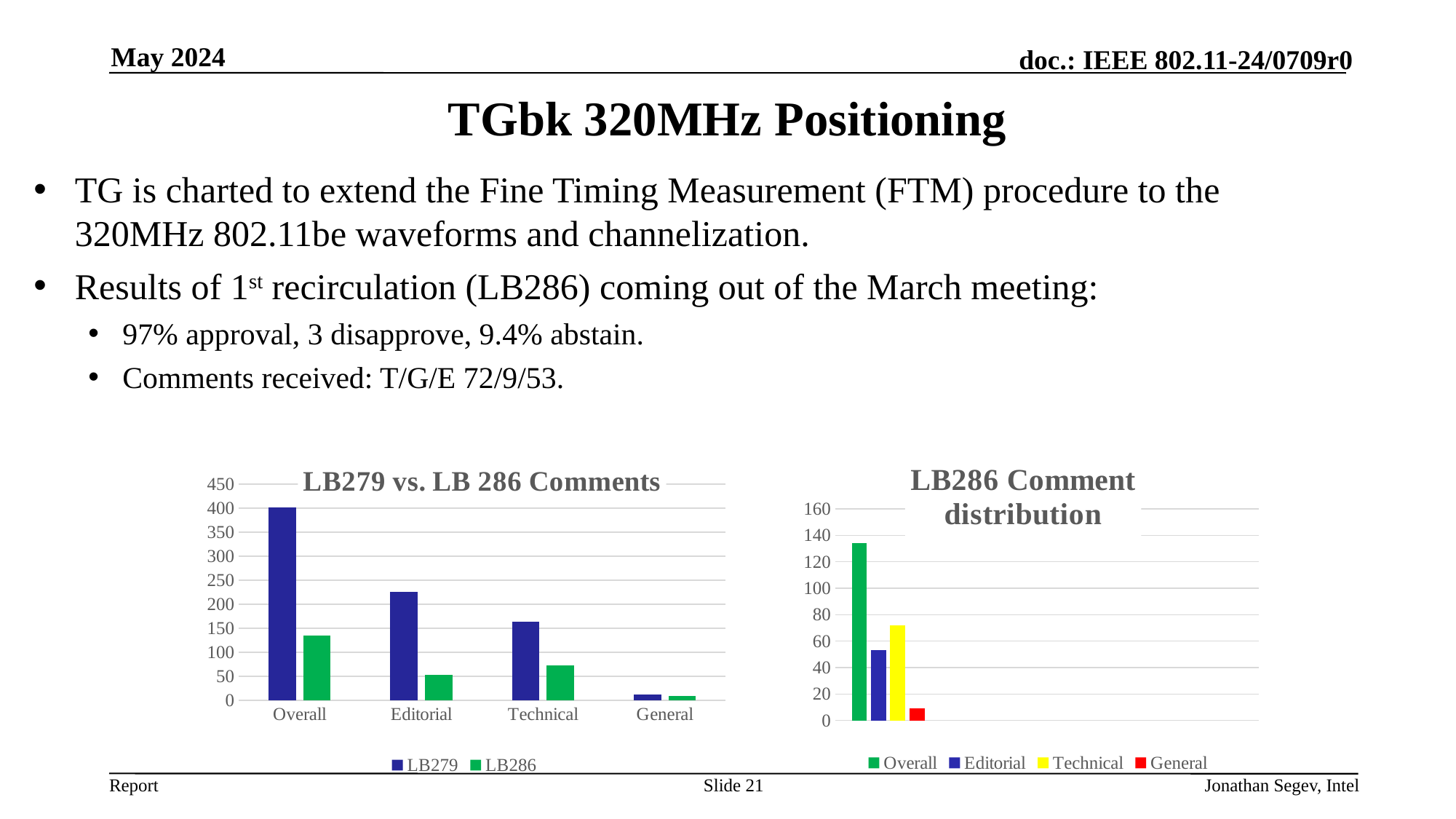
In the 'LB279 vs. LB 286 Comments' chart, how many series does the legend list? 2 In the 'LB286 Comment distribution' chart, which category has the highest value? Overall In the 'LB279 vs. LB 286 Comments' chart, how many categories are shown on the x axis? 4 In the 'LB279 vs. LB 286 Comments' chart, which is larger for LB286: Technical or Editorial? Technical In the 'LB279 vs. LB 286 Comments' chart, which category has the highest LB279 value? Overall In the 'LB279 vs. LB 286 Comments' chart, which category has the lowest LB279 value? General In the 'LB279 vs. LB 286 Comments' chart, is the LB279 value for Editorial greater or less than 200? greater In the 'LB286 Comment distribution' chart, is the value for Editorial greater or less than 60? less What kind of chart is the 'LB286 Comment distribution' chart? bar chart What kind of chart is the 'LB279 vs. LB 286 Comments' chart? bar chart In the 'LB286 Comment distribution' chart, which category has the lowest value? General In the 'LB279 vs. LB 286 Comments' chart, is the LB286 value for Overall greater or less than 100? greater